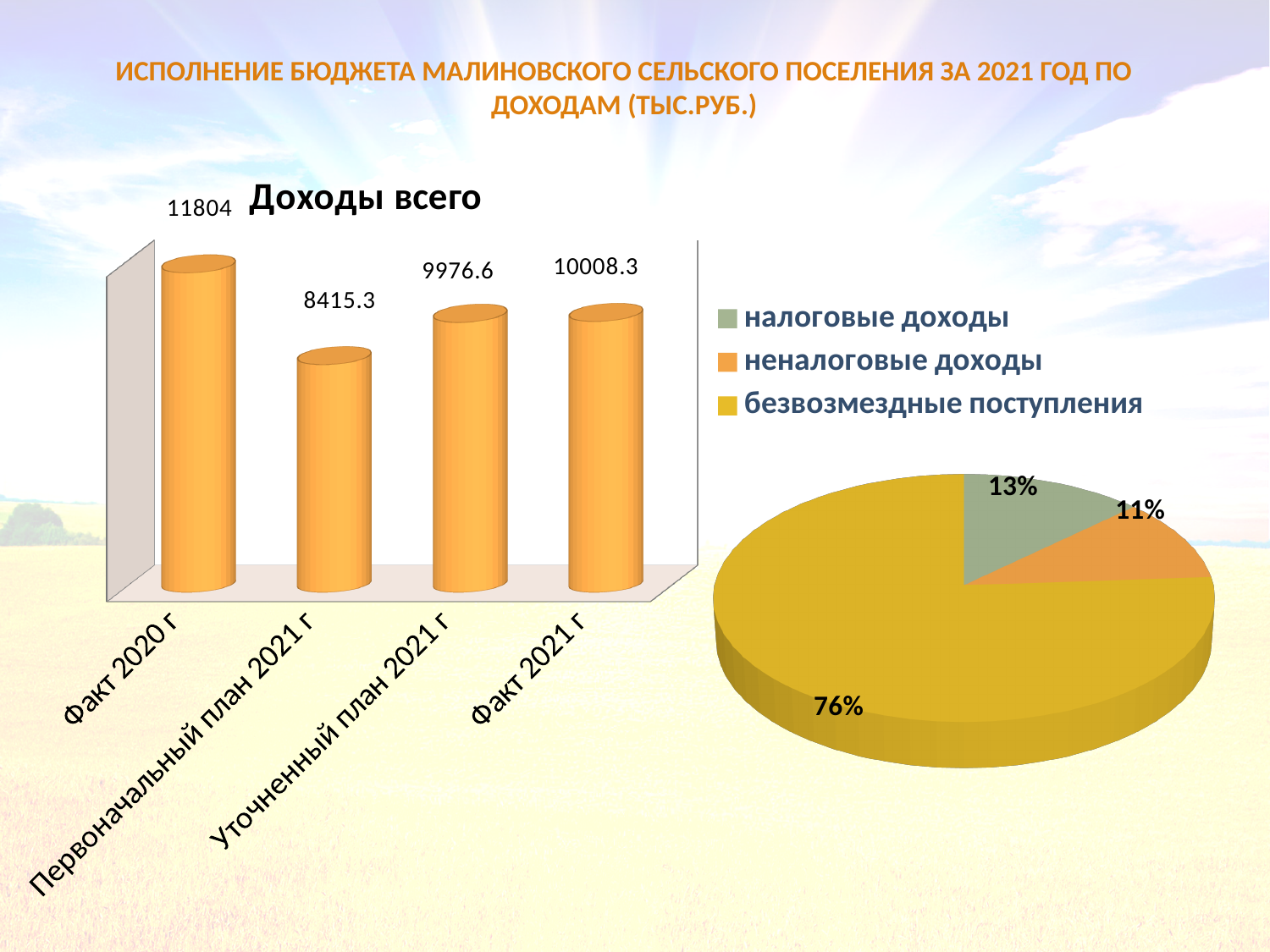
In the pie chart on the right, which slice is the smallest? неналоговые доходы In the 'Доходы всего' chart, which category has the lowest value? Первоначальный план 2021 г In the 'Доходы всего' chart, which category has the highest value? Факт 2020 г In the pie chart on the right, what share is 'безвозмездные поступления'? 76% In the pie chart on the right, what share is 'налоговые доходы'? 13% In the 'Доходы всего' chart, what is the difference between 'Факт 2020 г' and 'Факт 2021 г'? 1795.7 In the 'Доходы всего' chart, what is the value for 'Факт 2021 г'? 10008.3 How many categories are shown in the 'Доходы всего' chart? 4 In the 'Доходы всего' chart, what is the value for 'Первоначальный план 2021 г'? 8415.3 How many entries does the legend of the pie chart on the right list? 3 In the 'Доходы всего' chart, which is larger: 'Уточненный план 2021 г' or 'Первоначальный план 2021 г'? Уточненный план 2021 г What kind of chart is the 'Доходы всего' chart? bar chart